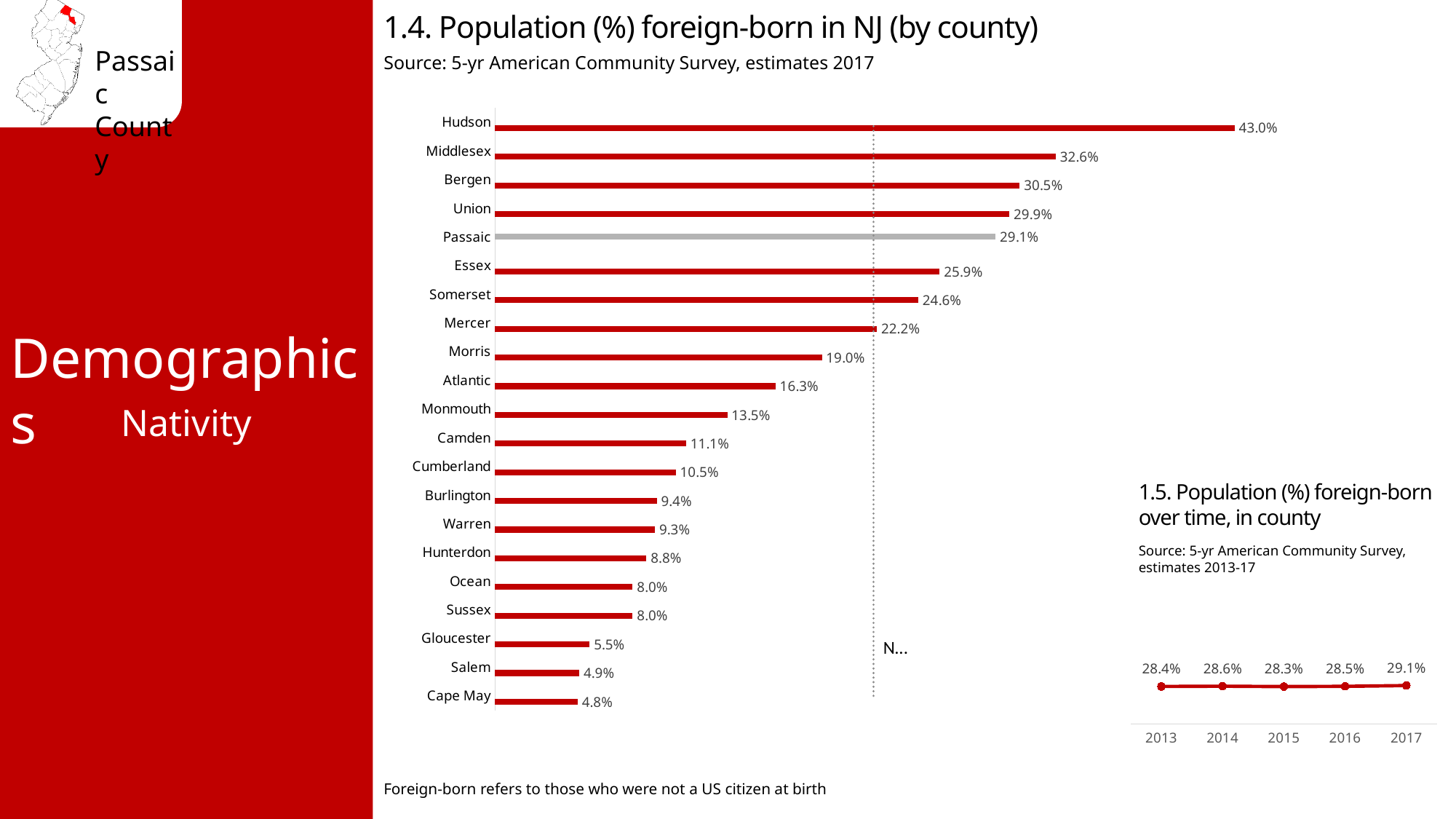
In the chart '1.5. Population (%) foreign-born over time, in county', what is the value for 2015? 28.3% In the chart '1.5. Population (%) foreign-born over time, in county', which year has the highest value? 2017 What kind of chart is '1.5. Population (%) foreign-born over time, in county'? Line chart In the chart '1.4. Population (%) foreign-born in NJ (by county)', what is the difference between Hudson and Middlesex? 10.4% In the chart '1.4. Population (%) foreign-born in NJ (by county)', which is larger, Essex or Somerset? Essex In the chart '1.4. Population (%) foreign-born in NJ (by county)', which county has the highest value? Hudson What kind of chart is '1.4. Population (%) foreign-born in NJ (by county)'? Bar chart In the chart '1.4. Population (%) foreign-born in NJ (by county)', how many counties are shown? 21 In the chart '1.4. Population (%) foreign-born in NJ (by county)', what is the value for Passaic? 29.1% In the chart '1.4. Population (%) foreign-born in NJ (by county)', which county's bar is shown in grey instead of red? Passaic In the chart '1.4. Population (%) foreign-born in NJ (by county)', what is the value for Mercer? 22.2% In the chart '1.4. Population (%) foreign-born in NJ (by county)', which county has the lowest value? Cape May